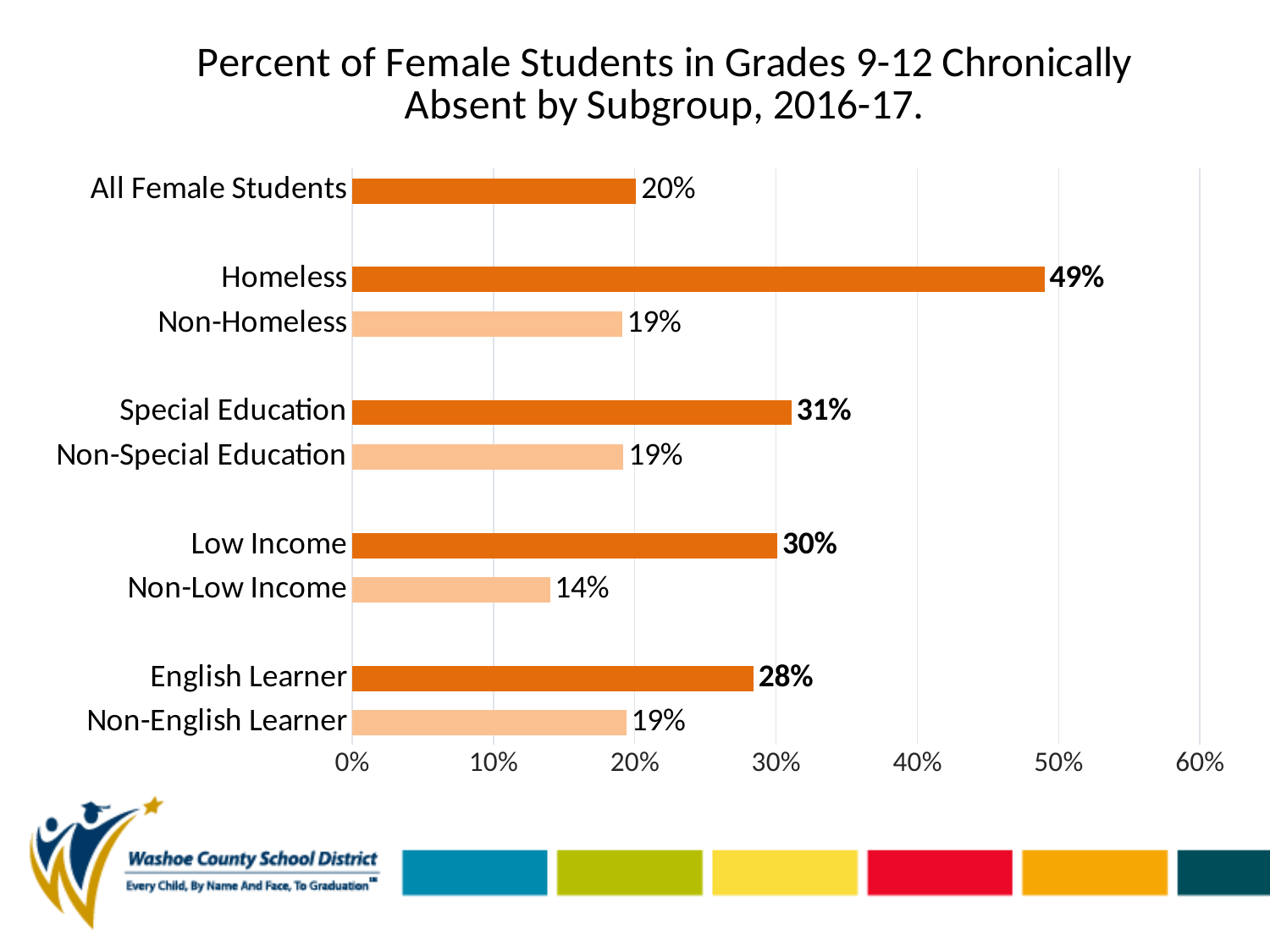
What is the title of the chart? Percent of Female Students in Grades 9-12 Chronically Absent by Subgroup, 2016-17. What is the value for All Female Students? 20% How many subgroup bars are shown in the chart? 9 Which subgroup has the highest value? Homeless What is the difference between the values for Homeless and Non-Homeless? 30% What kind of chart is shown on the slide? Bar chart Which is larger, the value for Special Education or the value for English Learner? Special Education What is the value for Non-Low Income? 14% What is the value for Homeless? 49% What is the value for English Learner? 28% What is the difference between the values for Low Income and Non-Low Income? 16% Which subgroup has the lowest value? Non-Low Income